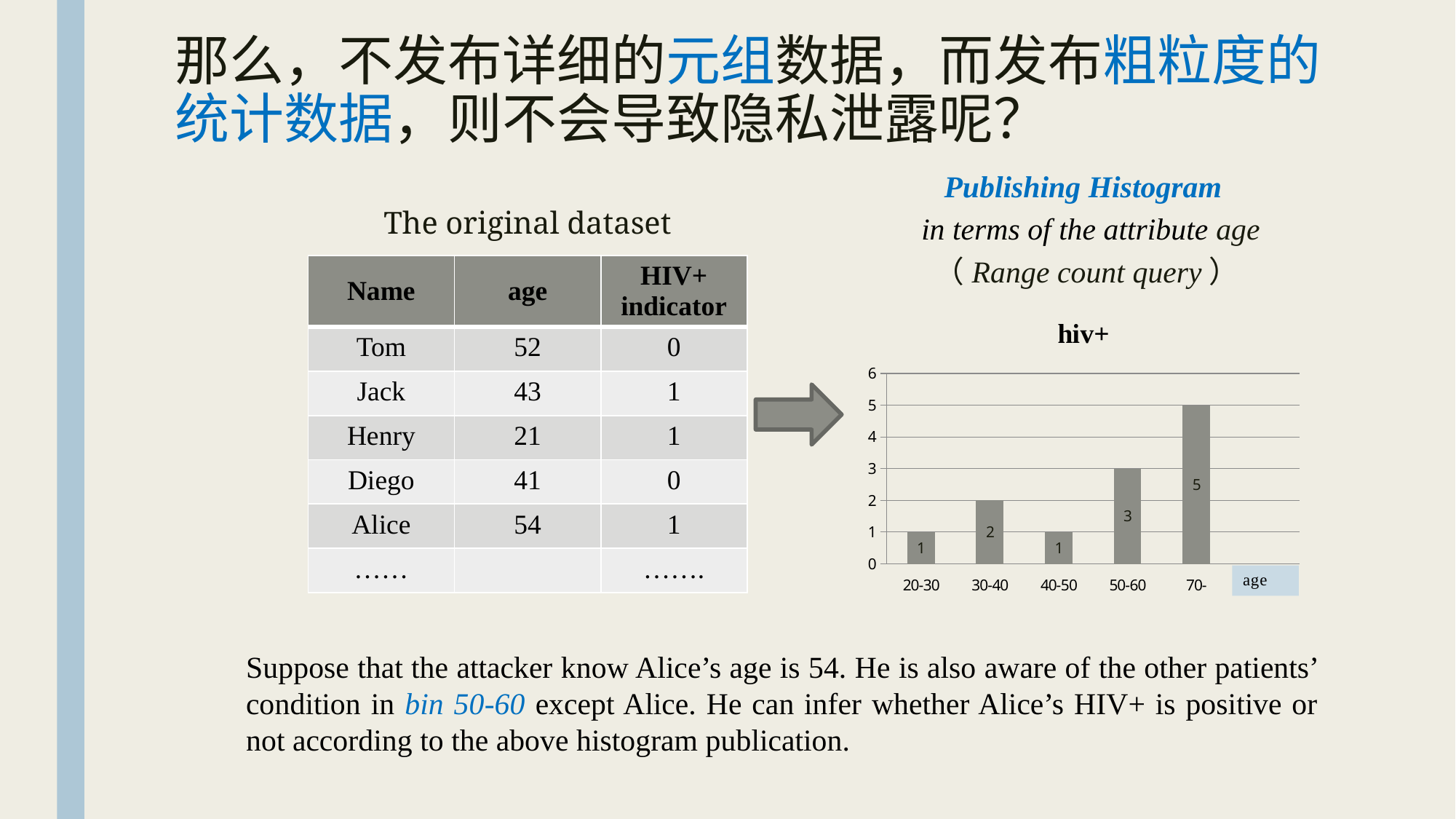
What is the value for the 50-60 age bin in the hiv+ chart? 3 Is the value for the 70- bin in the hiv+ chart greater or less than 4? greater What is the difference between the values for the 70- and 50-60 bins in the hiv+ chart? 2 What is the title of the chart on the slide? hiv+ Which is larger in the hiv+ chart, the value for 30-40 or the value for 40-50? 30-40 What is the value for the 30-40 age bin in the hiv+ chart? 2 Which age bin has the highest value in the hiv+ chart? 70- What kind of chart is the hiv+ chart? bar chart How many age bins are shown in the hiv+ chart? 5 What is the value for the 70- age bin in the hiv+ chart? 5 What is the difference between the values for the 50-60 and 20-30 bins in the hiv+ chart? 2 What is the label shown on the x axis of the hiv+ chart? age